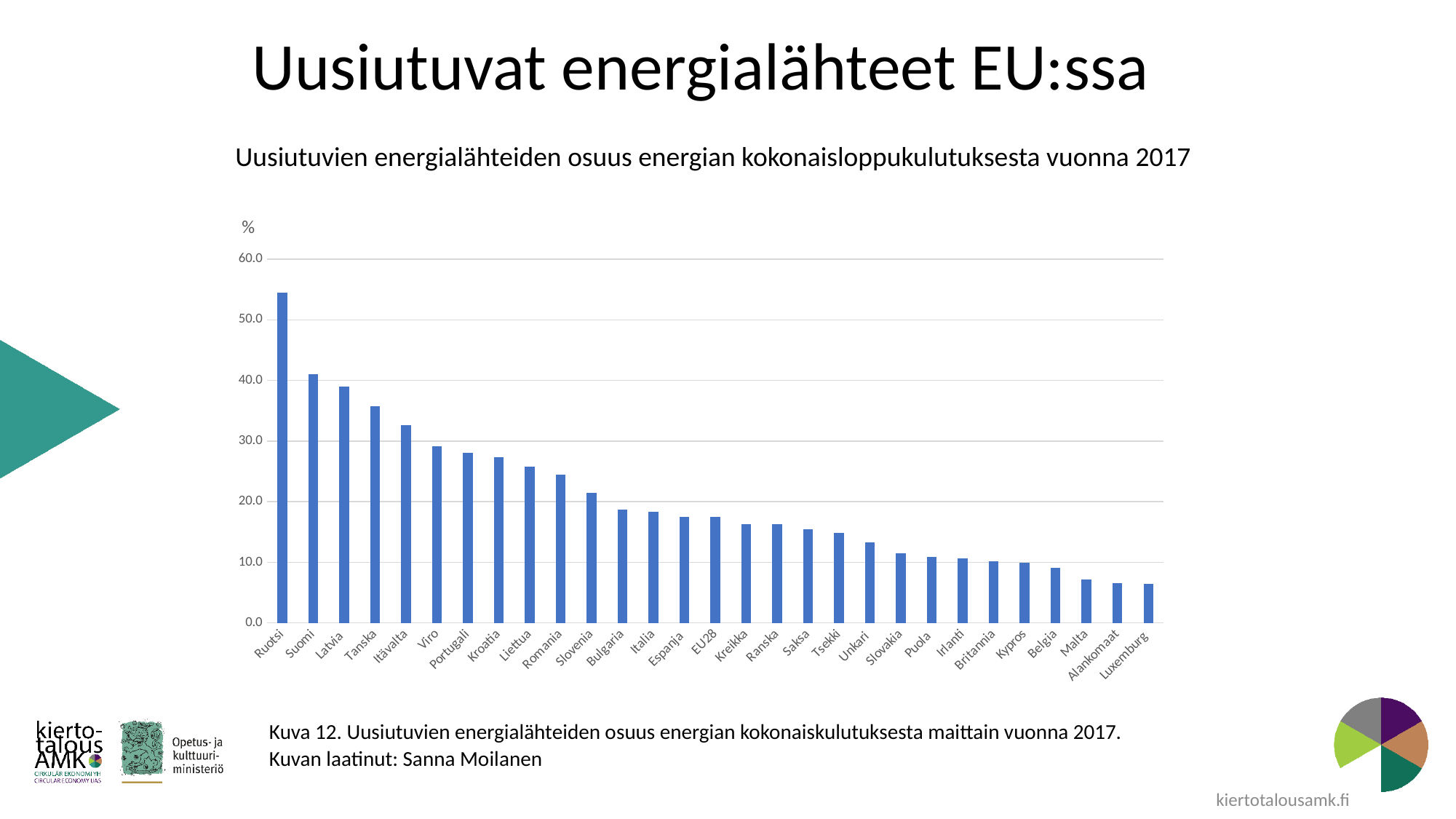
Do the values rise or fall from left to right along the x axis? fall What kind of chart is shown on the slide? bar chart Which country has the lowest share of renewable energy in the chart? Luxemburg Is the value for Saksa greater or less than 20? less What unit is shown on the vertical axis of the chart? % How many categories (bars) are shown in the chart? 29 Which country has the highest share of renewable energy in the chart? Ruotsi Is the value for Tanska greater or less than 40? less Which has a larger value, Latvia or Viro? Latvia Is the value for Ruotsi greater or less than 50? greater